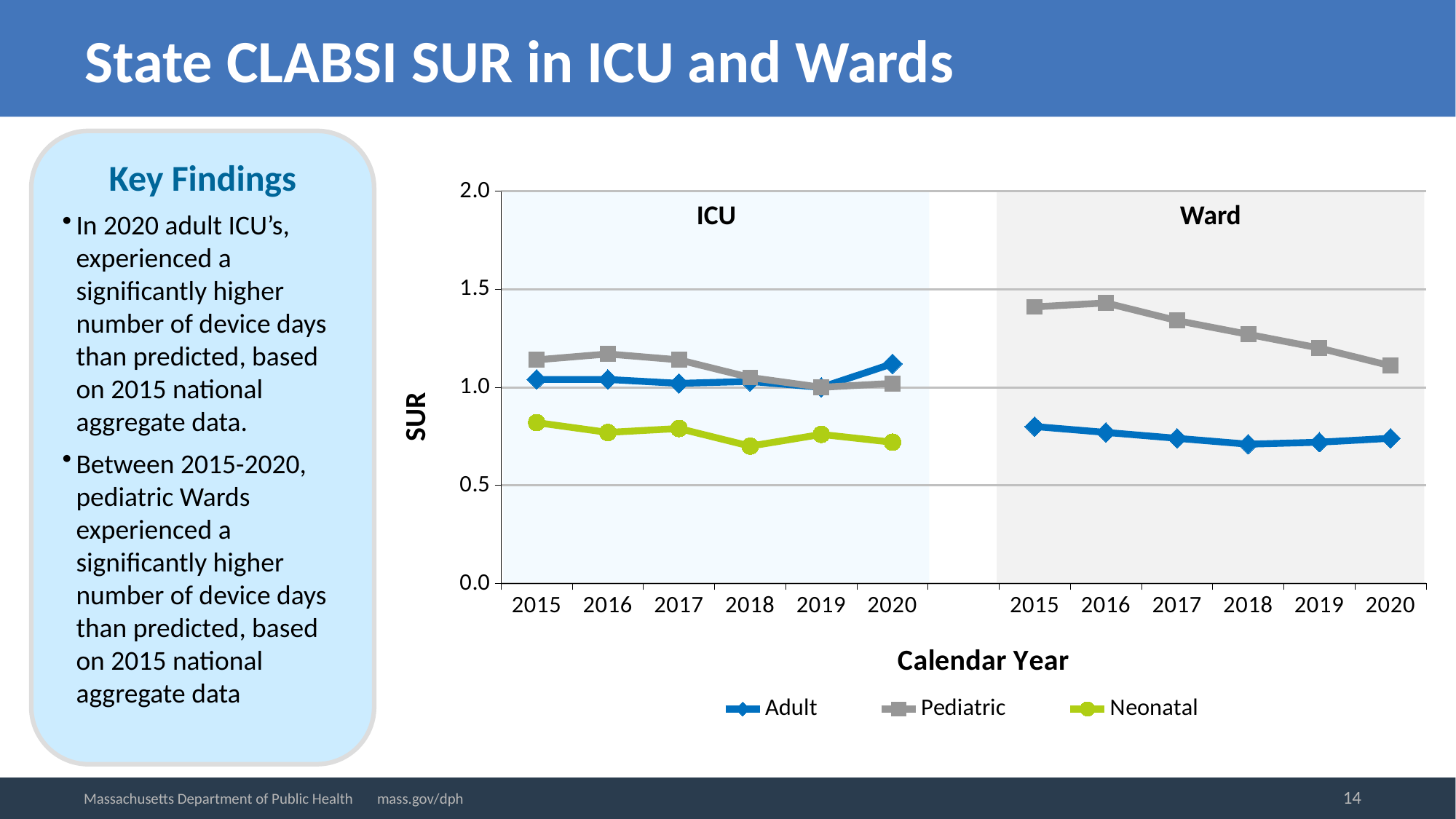
In the Ward panel, does the Pediatric SUR rise or fall from 2016 to 2020? fall In the Ward panel, is the Pediatric SUR for 2015 greater or less than 1.0? greater In the ICU panel for 2015, which series has the higher SUR, Adult or Pediatric? Pediatric How many series does the legend list? 3 In the ICU panel, is the Neonatal SUR for 2018 greater or less than 1.0? less What type of chart is shown on the slide? line chart What are the series names listed in the legend? Adult, Pediatric, Neonatal Which series is plotted only in the ICU panel and not in the Ward panel? Neonatal In the Ward panel, which year has the lowest Pediatric SUR? 2020 In the Ward panel, is the Adult SUR for 2018 greater or less than 1.0? less How many calendar years are plotted in the ICU panel? 6